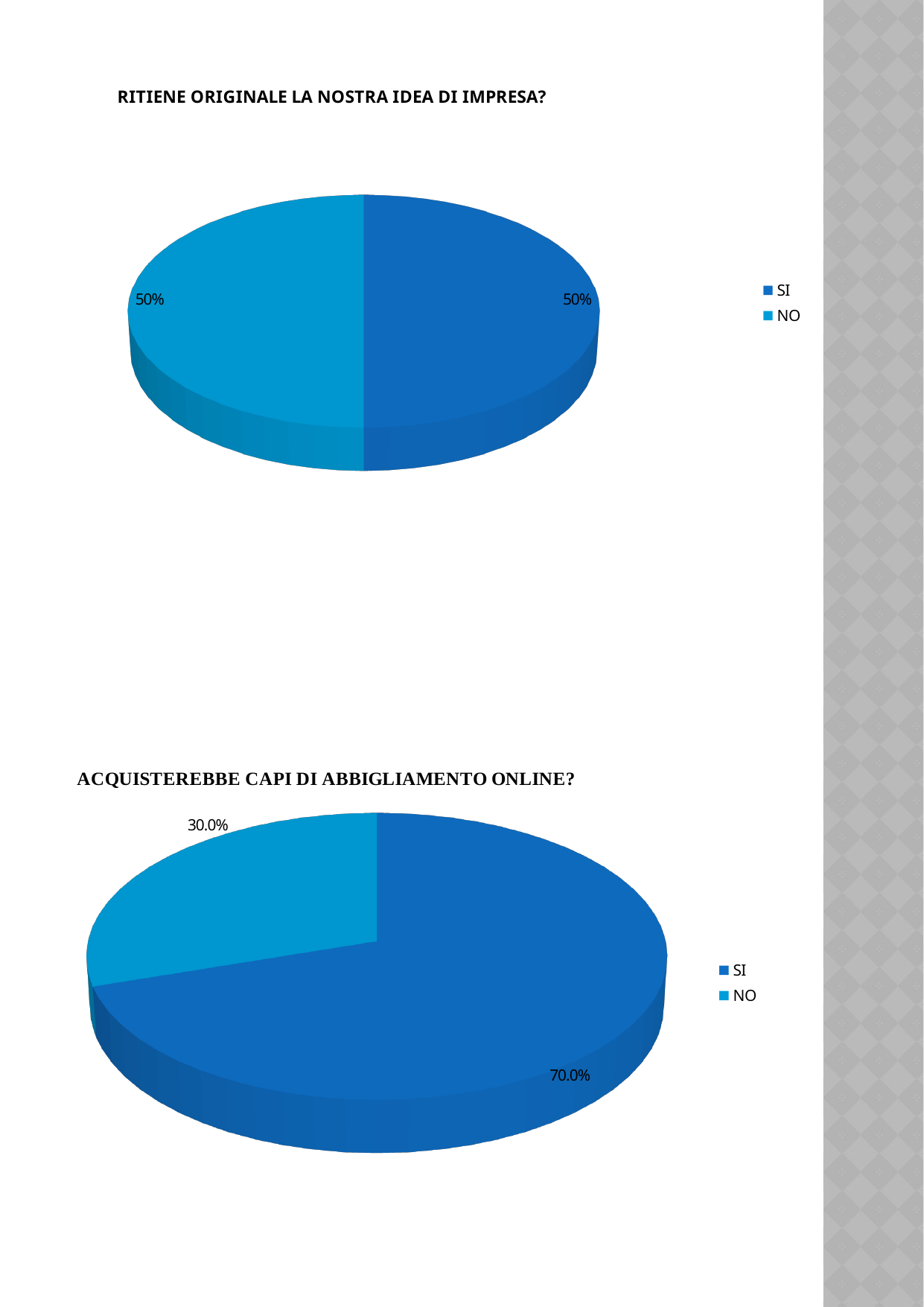
In the chart titled "ACQUISTEREBBE CAPI DI ABBIGLIAMENTO ONLINE?", what share of the pie is NO? 30.0% In the chart titled "ACQUISTEREBBE CAPI DI ABBIGLIAMENTO ONLINE?", what is the difference between the SI and NO shares? 40.0% In the chart titled "ACQUISTEREBBE CAPI DI ABBIGLIAMENTO ONLINE?", what share of the pie is SI? 70.0% How many entries does the legend of the bottom chart list? 2 In the chart titled "RITIENE ORIGINALE LA NOSTRA IDEA DI IMPRESA?", what share of the pie is NO? 50% In the chart titled "RITIENE ORIGINALE LA NOSTRA IDEA DI IMPRESA?", how many slices does the pie have? 2 What is the title of the top chart on the slide? RITIENE ORIGINALE LA NOSTRA IDEA DI IMPRESA? In the chart titled "ACQUISTEREBBE CAPI DI ABBIGLIAMENTO ONLINE?", which slice is the largest? SI In the chart titled "ACQUISTEREBBE CAPI DI ABBIGLIAMENTO ONLINE?", which slice is the smallest? NO What kind of chart is the top chart on the slide? Pie chart In the chart titled "ACQUISTEREBBE CAPI DI ABBIGLIAMENTO ONLINE?", which is larger, SI or NO? SI